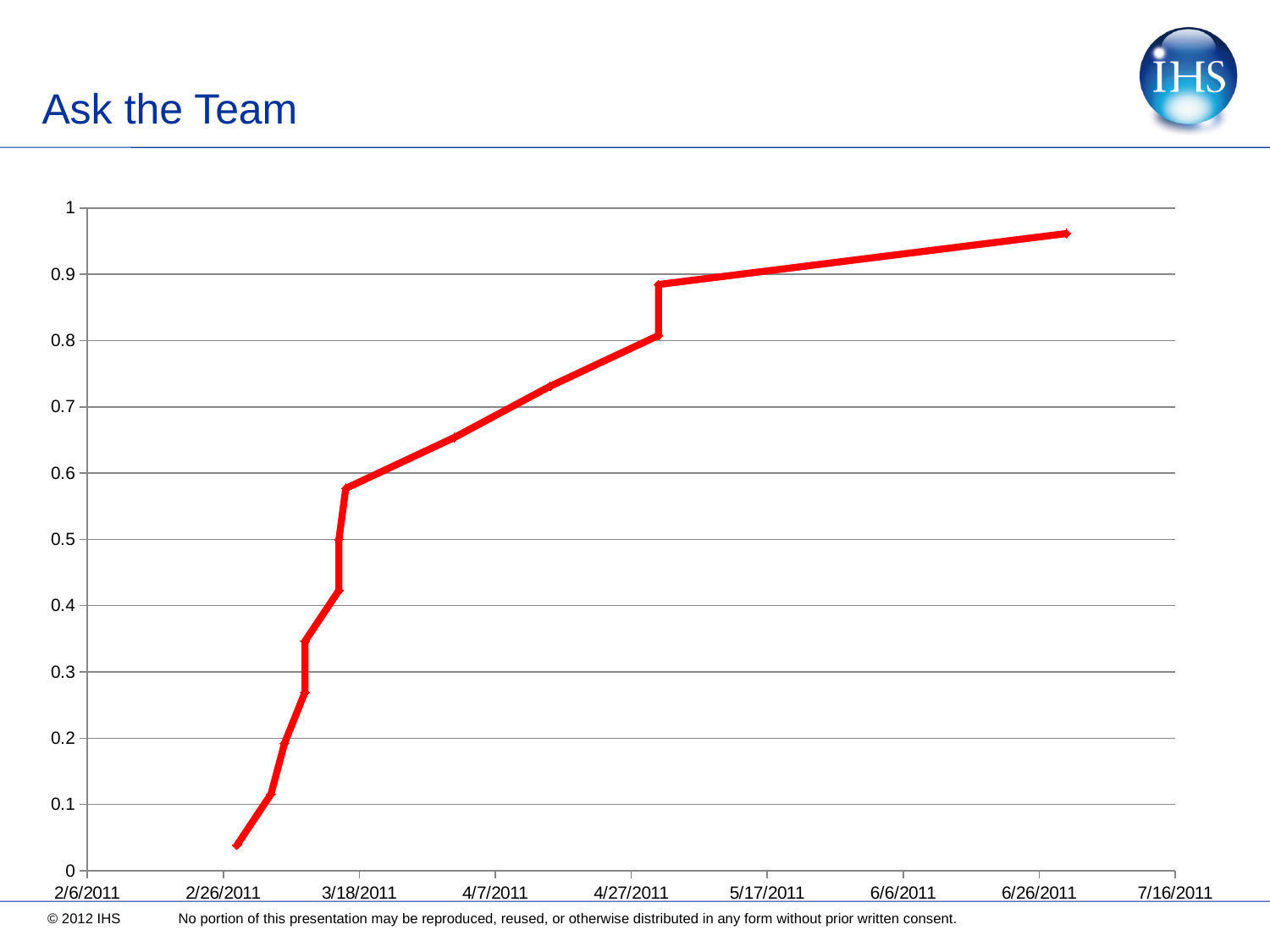
Do the values on the chart rise or fall as the dates move from left to right along the x axis? rise Is the value at the first (leftmost) point of the line greater or less than 0.1? less What is the first date label shown on the x axis? 2/6/2011 Which is larger, the value of the line at 3/18/2011 or at 4/27/2011? 4/27/2011 Is the value at the last (rightmost) point of the line greater or less than 0.9? greater What is the highest tick label shown on the y axis? 1 Is the value of the line at 3/18/2011 greater or less than 0.7? less What kind of chart is shown on the slide? line chart